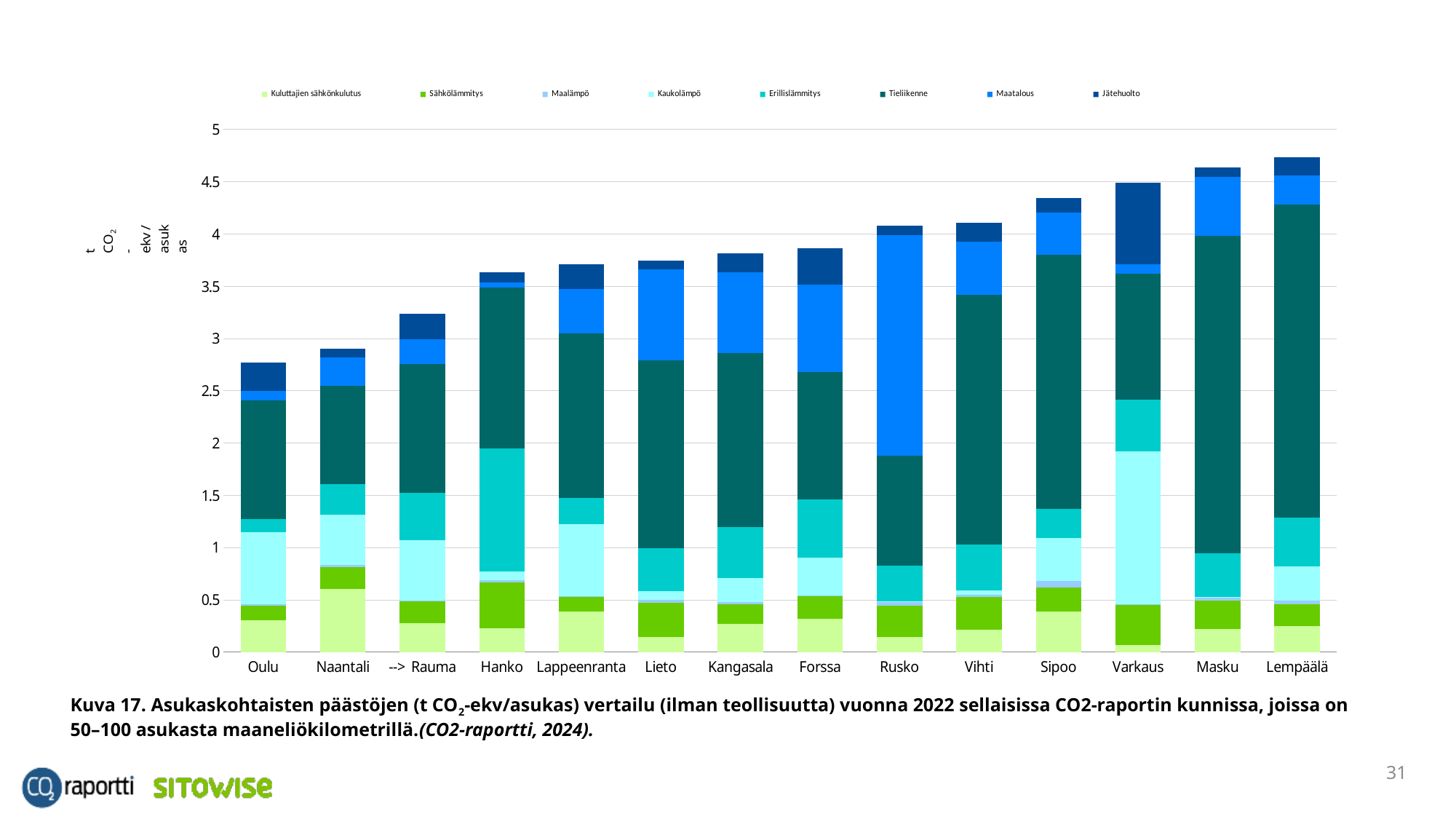
Which municipality has the largest Maatalous segment in the chart? Rusko Which has a larger total value, Rusko or Hanko? Rusko Which municipality has the lowest total emissions per inhabitant in the chart? Oulu Which municipality has the highest total emissions per inhabitant in the chart? Lempäälä Is the total value for Rusko greater or less than 4? greater Do the total bar heights rise or fall from left to right along the x axis? Rise How many series does the legend of the chart list? 8 Is the total value for Sipoo greater or less than 4.5? less Is the total value for Oulu greater or less than 3? less How many municipalities are shown on the x axis of the chart? 14 What kind of chart is shown on the slide? Stacked bar chart